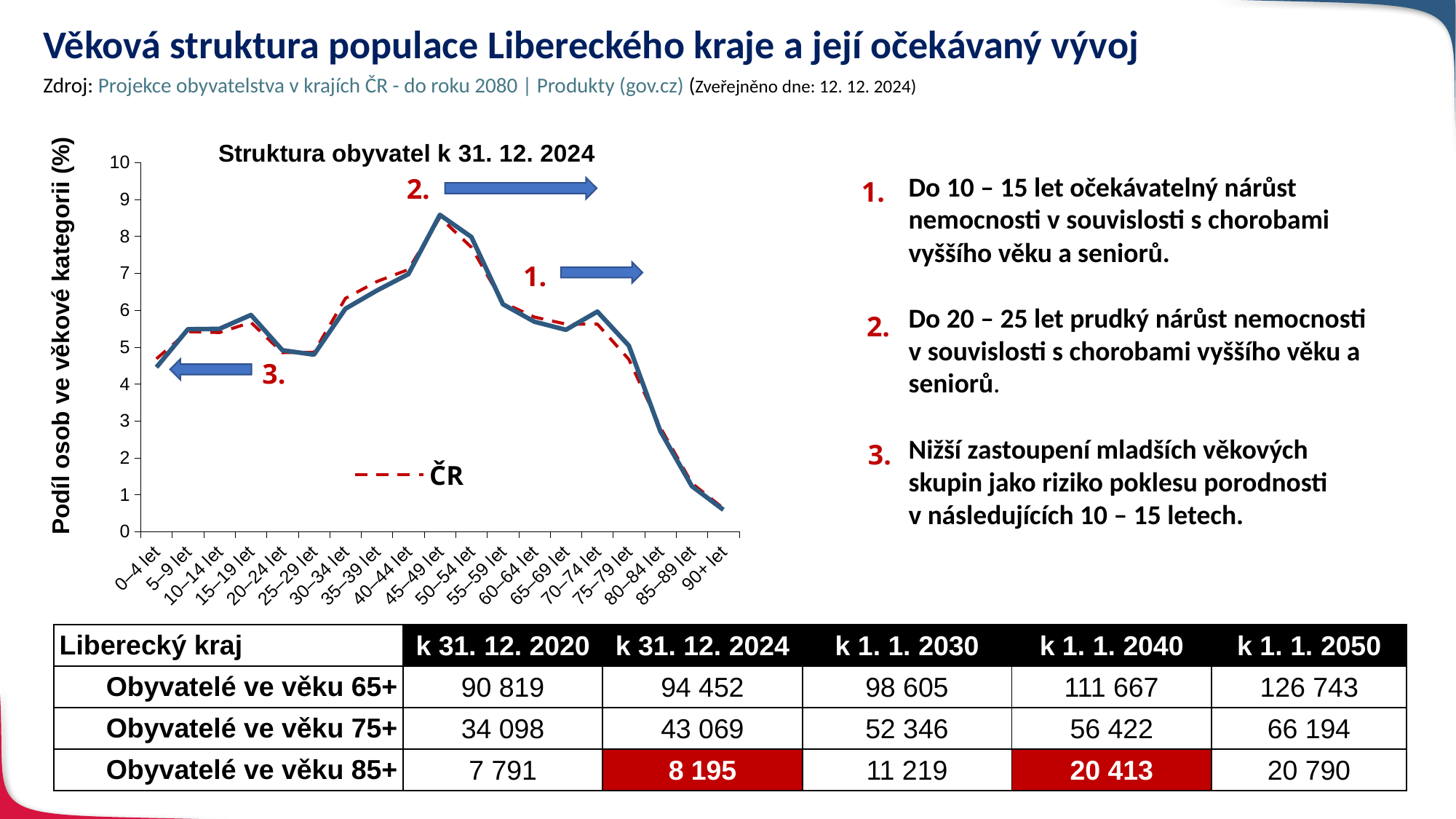
How many age categories are shown on the x axis of the chart? 19 Do the values rise or fall along the x axis from 45–49 let to 90+ let? fall Is the value for 80–84 let on the solid line greater or less than 3? less Which age category has the lowest share in the chart? 90+ let Is the value for 90+ let on the solid line greater or less than 1? less Is the value for 0–4 let on the solid line greater or less than 5? less Which has the larger value on the solid line: 45–49 let or 15–19 let? 45–49 let Which series is named in the chart's legend with a dashed red line? ČR What kind of chart is shown on the slide? line chart What is the title of the chart? Struktura obyvatel k 31. 12. 2024 Which age category has the highest share in the chart? 45–49 let